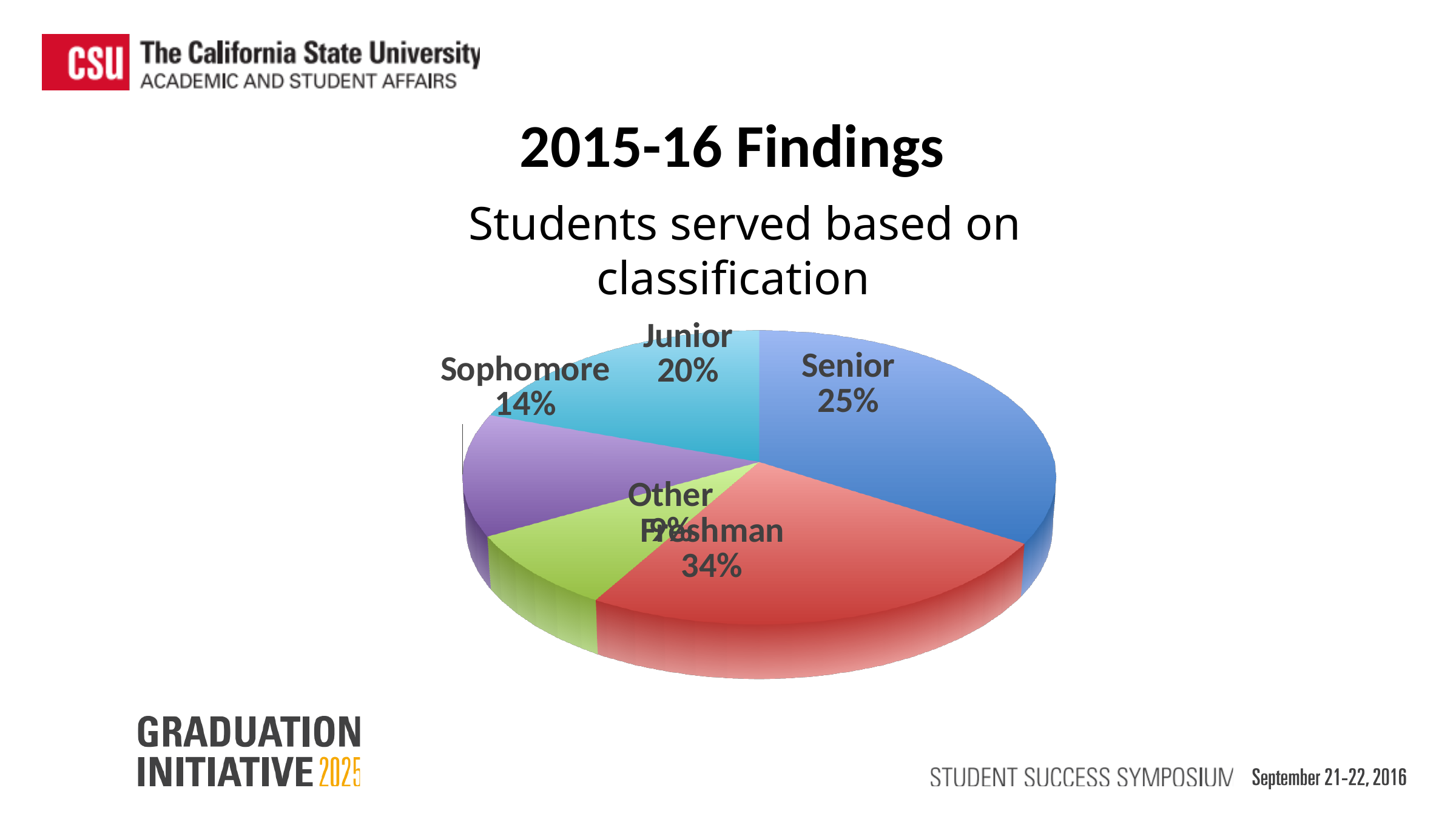
Which is larger, the Senior share or the Junior share? Senior Which classification has the smallest slice of the pie? Other How many classification categories are shown in the pie chart? 5 What type of chart is shown on the slide? Pie chart What percentage of students served were Freshmen? 34% What percentage of students served were Juniors? 20% What share of the pie is labelled Sophomore? 14% Which classification has the largest share of students served? Freshman How many percentage points larger is the Freshman share than the Senior share? 9 What percentage of students served were Seniors? 25% What is the title of the chart? Students served based on classification What is the difference in percentage points between the Junior and Sophomore shares? 6